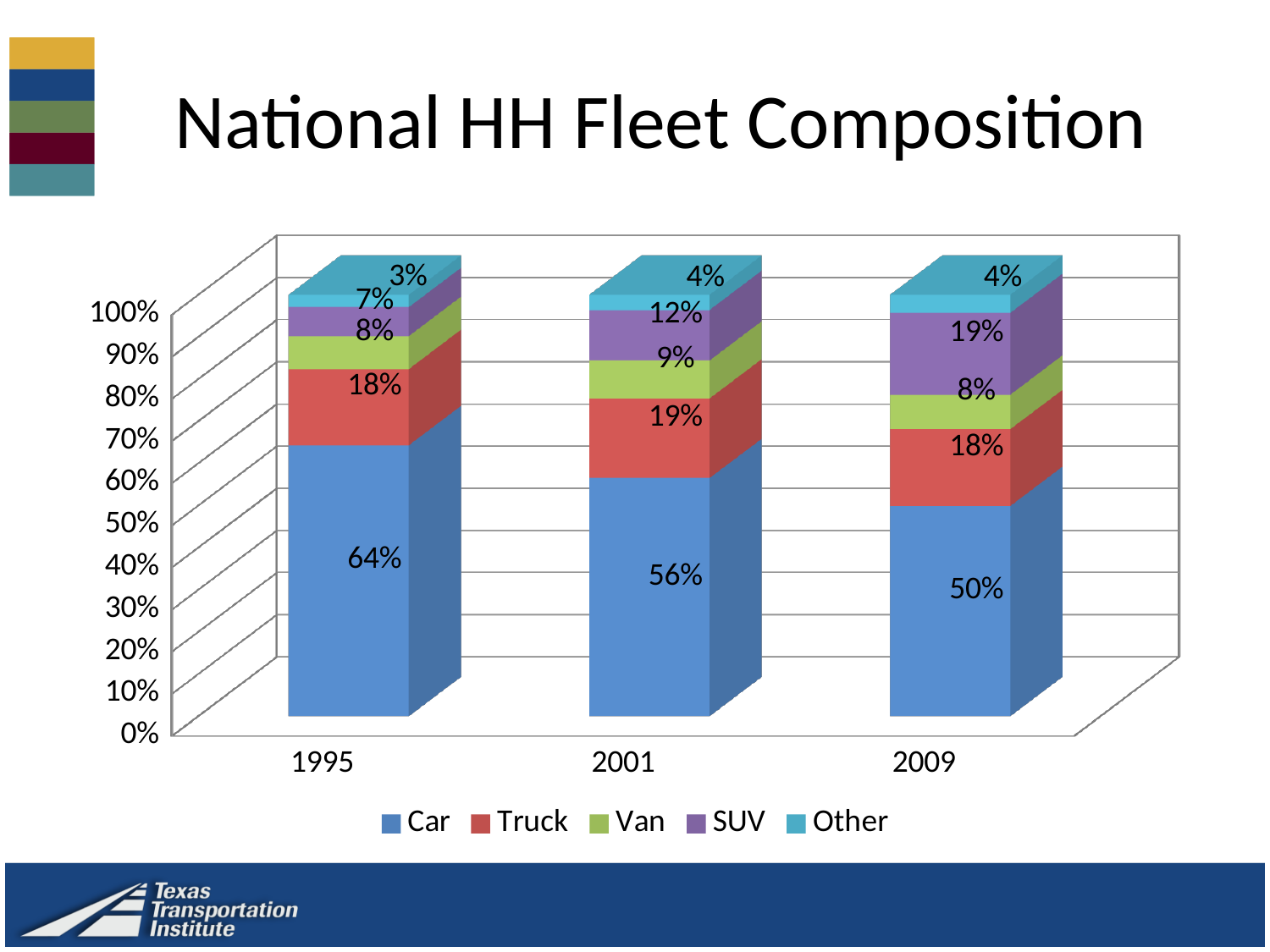
What is the Car share in 1995? 64% In which year is the SUV share the highest? 2009 How many series does the legend list? 5 What is the Truck share in 2001? 19% How many years are shown on the x axis? 3 What is the title of the chart? National HH Fleet Composition Does the Car share rise or fall from 1995 to 2009? Fall By how many percentage points did the Car share fall from 1995 to 2009? 14 percentage points What is the SUV share in 2009? 19% What kind of chart is shown on the slide? Stacked bar chart What is the Other share in 1995? 3% In which year is the Car share the lowest? 2009